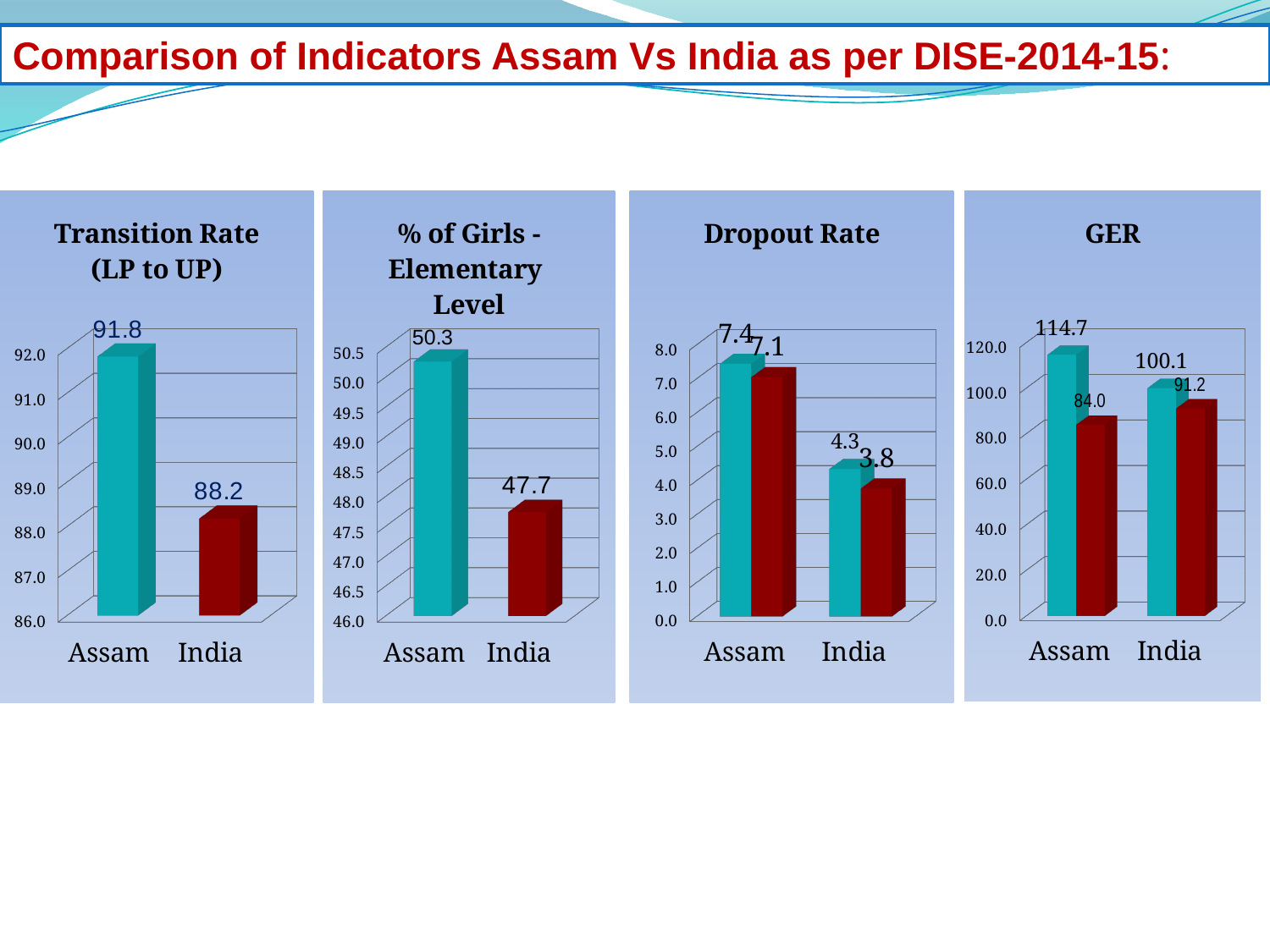
In the Transition Rate (LP to UP) chart, what is the value for Assam? 91.8 In the GER chart, what is the value of the teal bar for Assam? 114.7 In the Dropout Rate chart, what is the value of the red bar for India? 3.8 In the % of Girls - Elementary Level chart, what is the value for Assam? 50.3 In the % of Girls - Elementary Level chart, which category has the higher value, Assam or India? Assam In the % of Girls - Elementary Level chart, what is the value for India? 47.7 In the Transition Rate (LP to UP) chart, what is the value for India? 88.2 What kind of chart is the Transition Rate (LP to UP) chart? Bar chart In the Dropout Rate chart, what is the value of the teal bar for Assam? 7.4 In the % of Girls - Elementary Level chart, what is the difference between the Assam and India values? 2.6 In the Transition Rate (LP to UP) chart, what is the difference between the Assam and India values? 3.6 In the GER chart, is the value of the red bar for Assam greater or less than 100.0? less